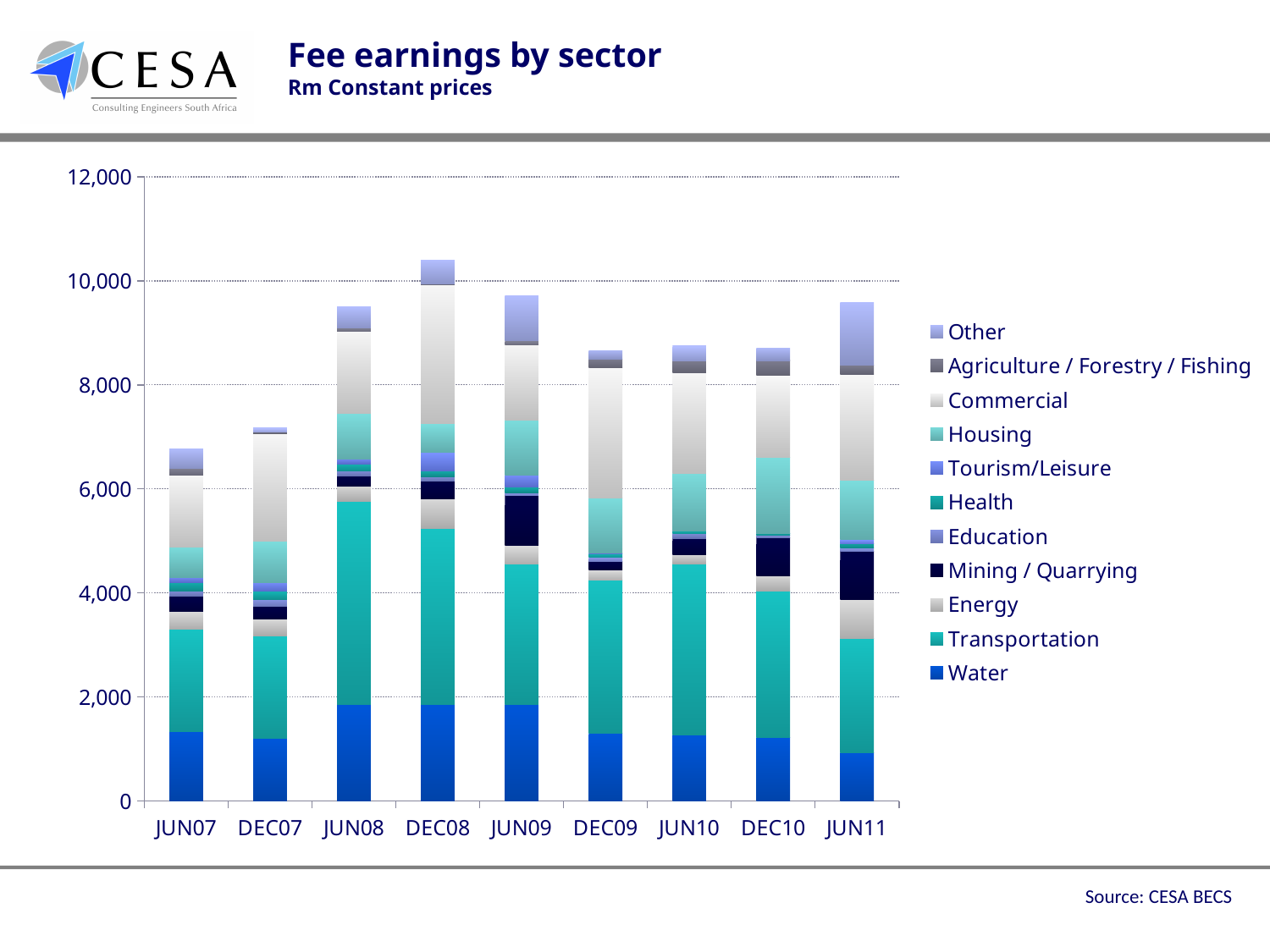
Is the total fee earnings for JUN07 greater or less than 8,000? less How many sectors does the legend list? 11 Is the total fee earnings for DEC08 greater or less than 10,000? greater Which period has the larger total fee earnings, JUN11 or DEC10? JUN11 Do total fee earnings rise or fall from JUN07 to DEC08? rise How many time periods are shown along the x axis? 9 Which period has the lowest total fee earnings? JUN07 Is the total fee earnings for JUN11 greater or less than 8,000? greater Which period has the highest total fee earnings? DEC08 What is the title of the chart? Fee earnings by sector What kind of chart is shown on the slide? Stacked bar chart Which sector forms the bottom segment of each stacked bar? Water